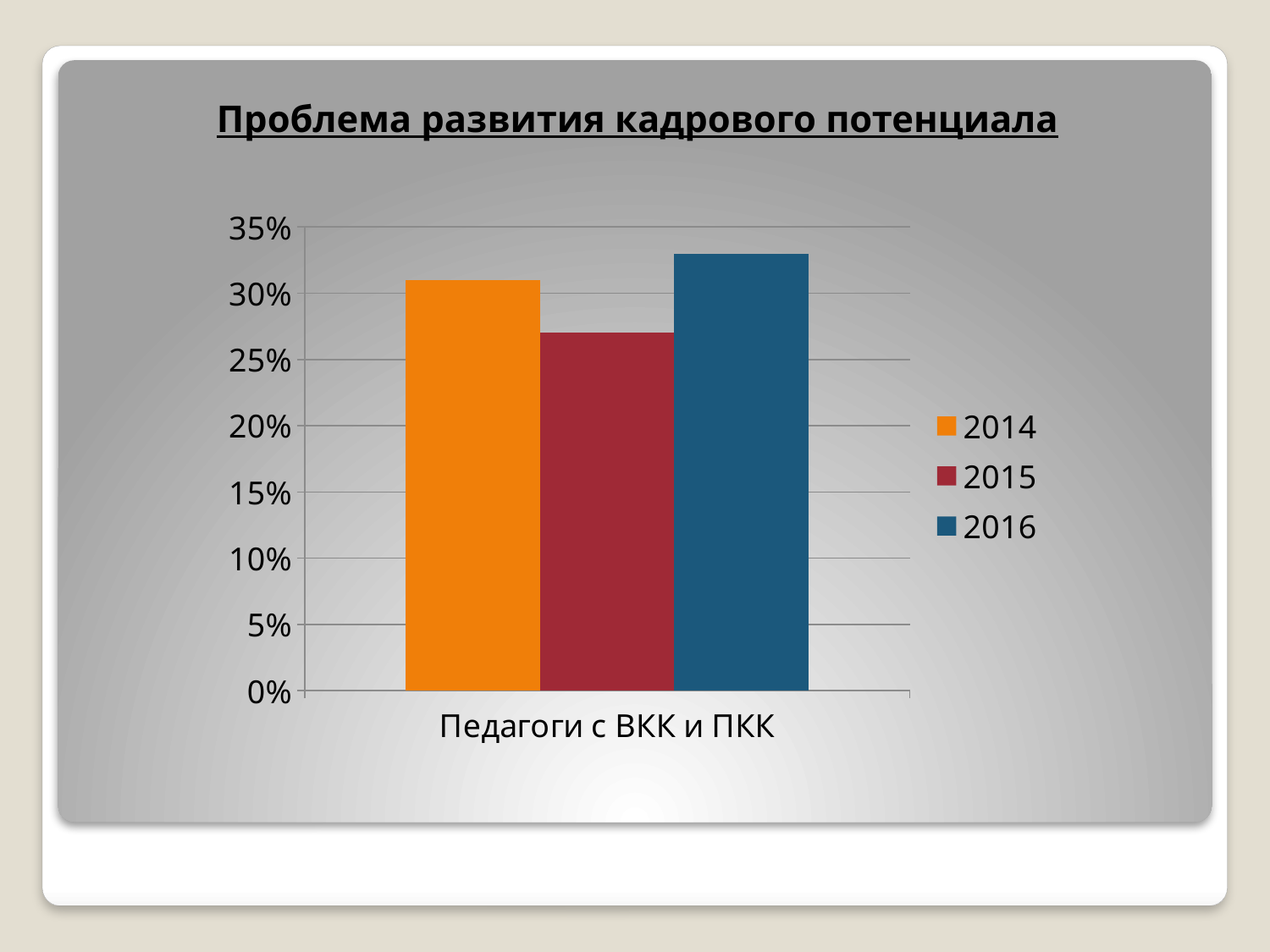
Is the value for 2015 greater or less than 30%? less What kind of chart is shown on the slide? bar chart Which year has the lowest value for Педагоги с ВКК и ПКК? 2015 How many series does the legend list? 3 Is the value for 2014 greater or less than 25%? greater Which year has the highest value for Педагоги с ВКК и ПКК? 2016 What is the title of the slide above the chart? Проблема развития кадрового потенциала Is the value for 2016 greater or less than 30%? greater Which is larger, the value for 2014 or the value for 2015? 2014 Which is larger, the value for 2015 or the value for 2016? 2016 How many categories are shown on the x axis? 1